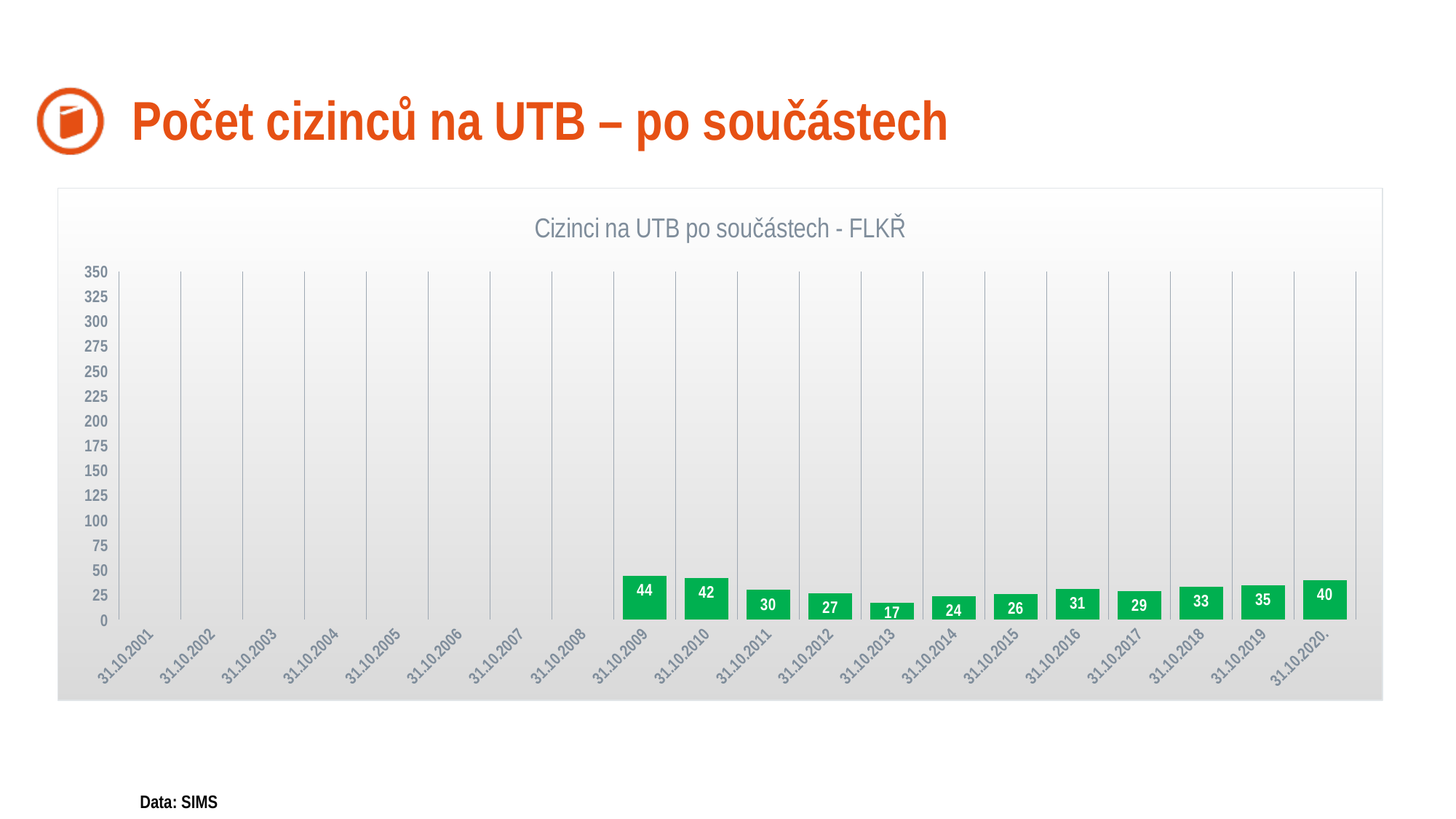
What is the value for 31.10.2020.? 40 Which date has the lowest value among the bars shown? 31.10.2013 Which date has the highest value among the bars shown? 31.10.2009 Is the value for 31.10.2010 greater or less than 50? less How many date categories are shown on the x axis? 20 What is the title of the chart? Cizinci na UTB po součástech - FLKŘ What is the value for 31.10.2009? 44 What is the value for 31.10.2013? 17 What kind of chart is this? bar chart Which is larger, the value for 31.10.2019 or the value for 31.10.2020.? 31.10.2020. What is the difference between the values for 31.10.2009 and 31.10.2013? 27 Do the values rise or fall from 31.10.2013 to 31.10.2020.? rise